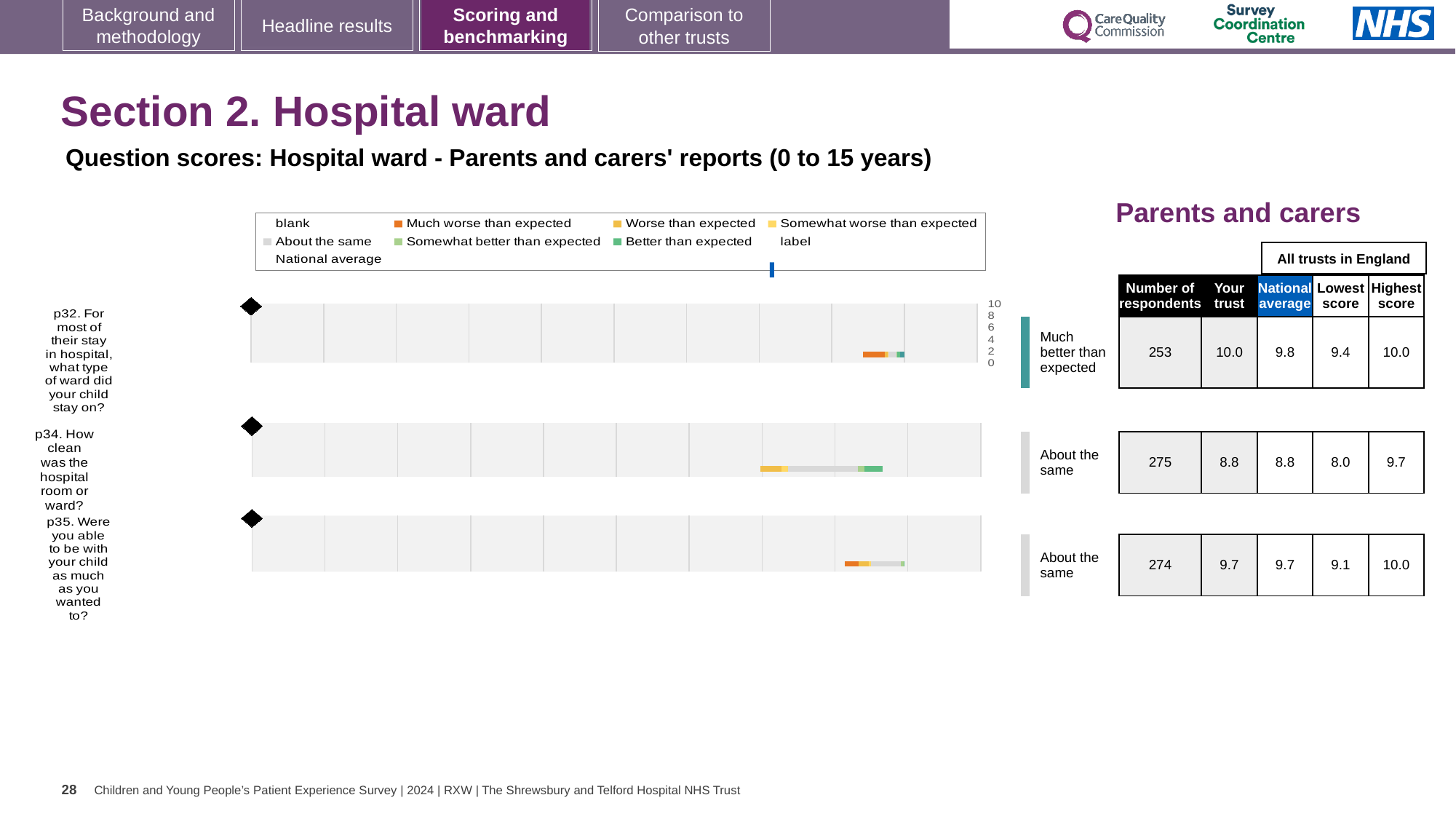
Which question has the highest 'Your trust' score? p32 Which question has the lowest number of respondents? p32 How many respondents answered p35 (were you able to be with your child as much as you wanted to)? 274 What benchmark category is shown for p32? Much better than expected What is the highest value shown on the chart axis? 10 How many questions (p32, p34, p35) have a chart on this slide? 3 What is the difference between the highest score and the lowest score for p34? 1.7 What is the national average score for p34 (how clean was the hospital room or ward)? 8.8 What colour represents 'Much worse than expected' in the legend? orange What kind of chart is used to show the p32 question scores? bar chart What is the 'Your trust' score for p32 (what type of ward did your child stay on)? 10.0 Which has the higher 'Your trust' score, p32 or p34? p32